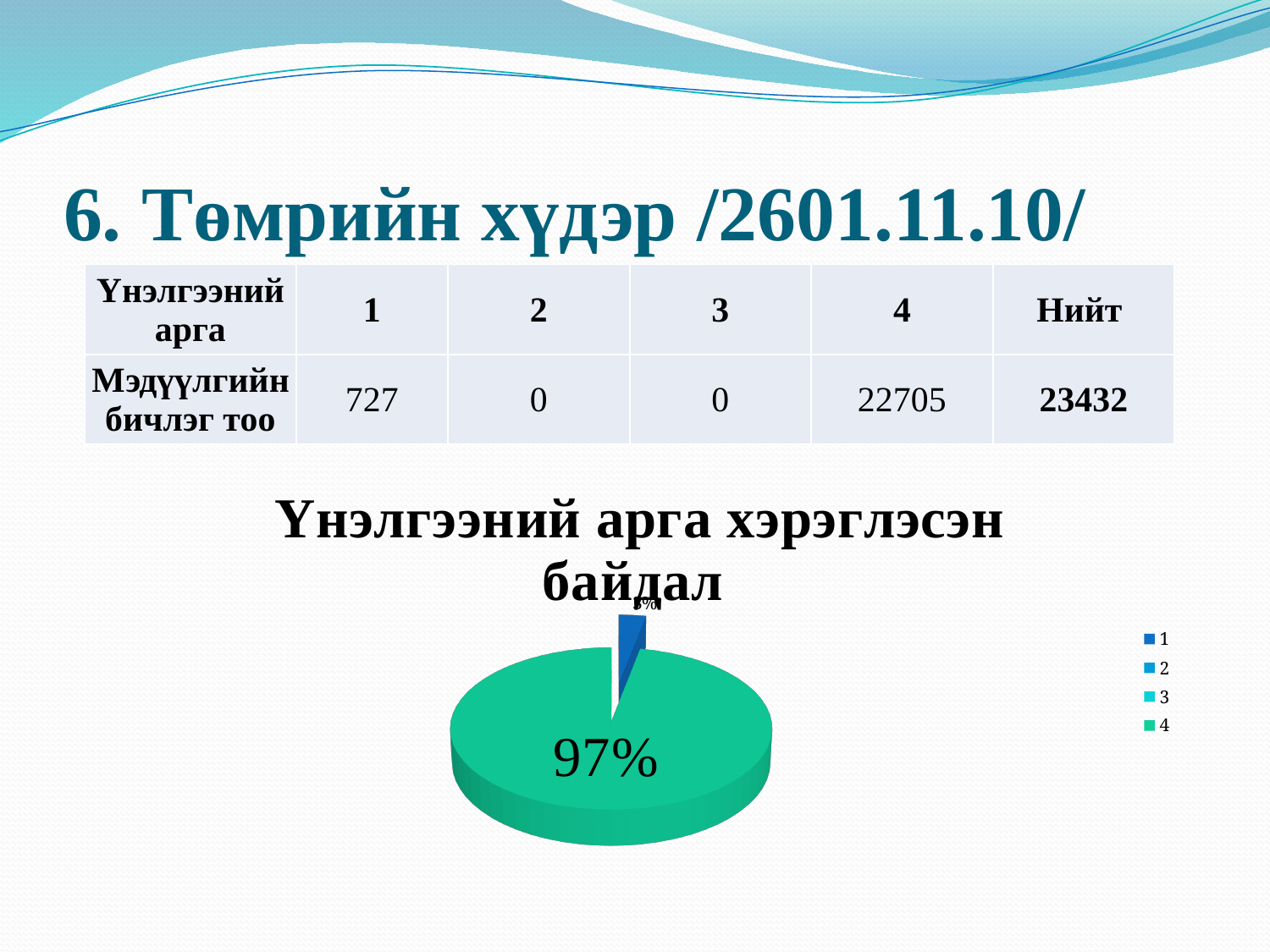
What colour is the largest slice of the pie? green What percentage share is printed on the largest slice of the pie? 97% How many entries does the chart's legend list? 4 What kind of chart is shown on the slide? pie chart Which slice is larger, the one for category 4 or the one for category 1? 4 Which category has the largest slice of the pie? 4 What is the title of the chart on the slide? Үнэлгээний арга хэрэглэсэн байдал Is the share for category 4 greater or less than 50%? greater